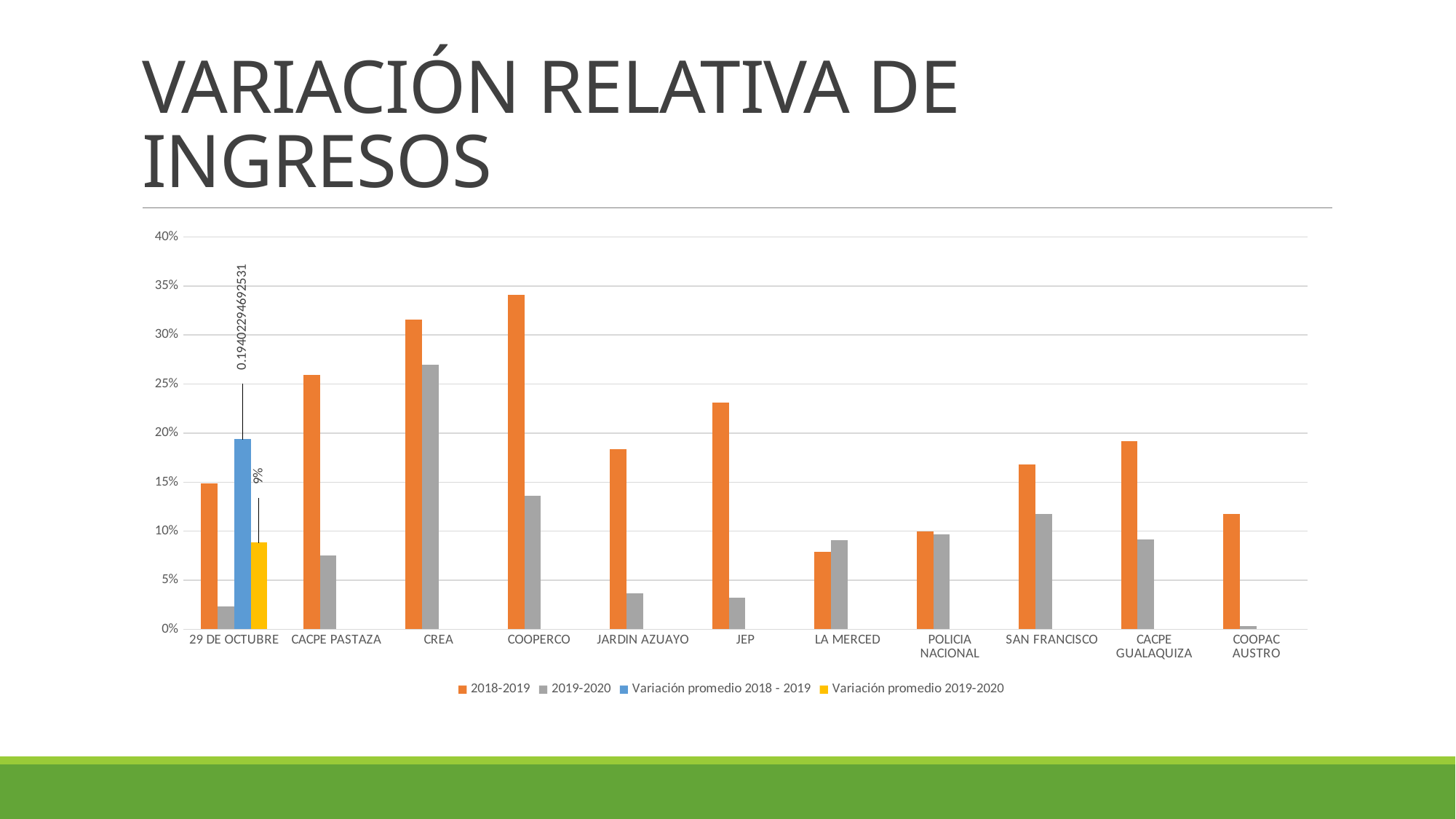
For JARDIN AZUAYO, which is larger: the 2018-2019 value or the 2019-2020 value? 2018-2019 Is the 2019-2020 value for JEP greater or less than 5%? less How many cooperatives (categories) are shown on the x axis? 11 Which cooperative has the highest 2018-2019 value? COOPERCO What kind of chart is shown on the slide? bar chart What value is printed on the data label for the 'Variación promedio 2018 - 2019' bar? 0.194022946925531 Which cooperative has the lowest 2018-2019 value? LA MERCED Which cooperative has the highest 2019-2020 value? CREA What value is printed on the data label for the 'Variación promedio 2019-2020' bar? 9% Which cooperative has the lowest 2019-2020 value? COOPAC AUSTRO Is the 2018-2019 value for CREA greater or less than 30%? greater How many series does the legend list? 4